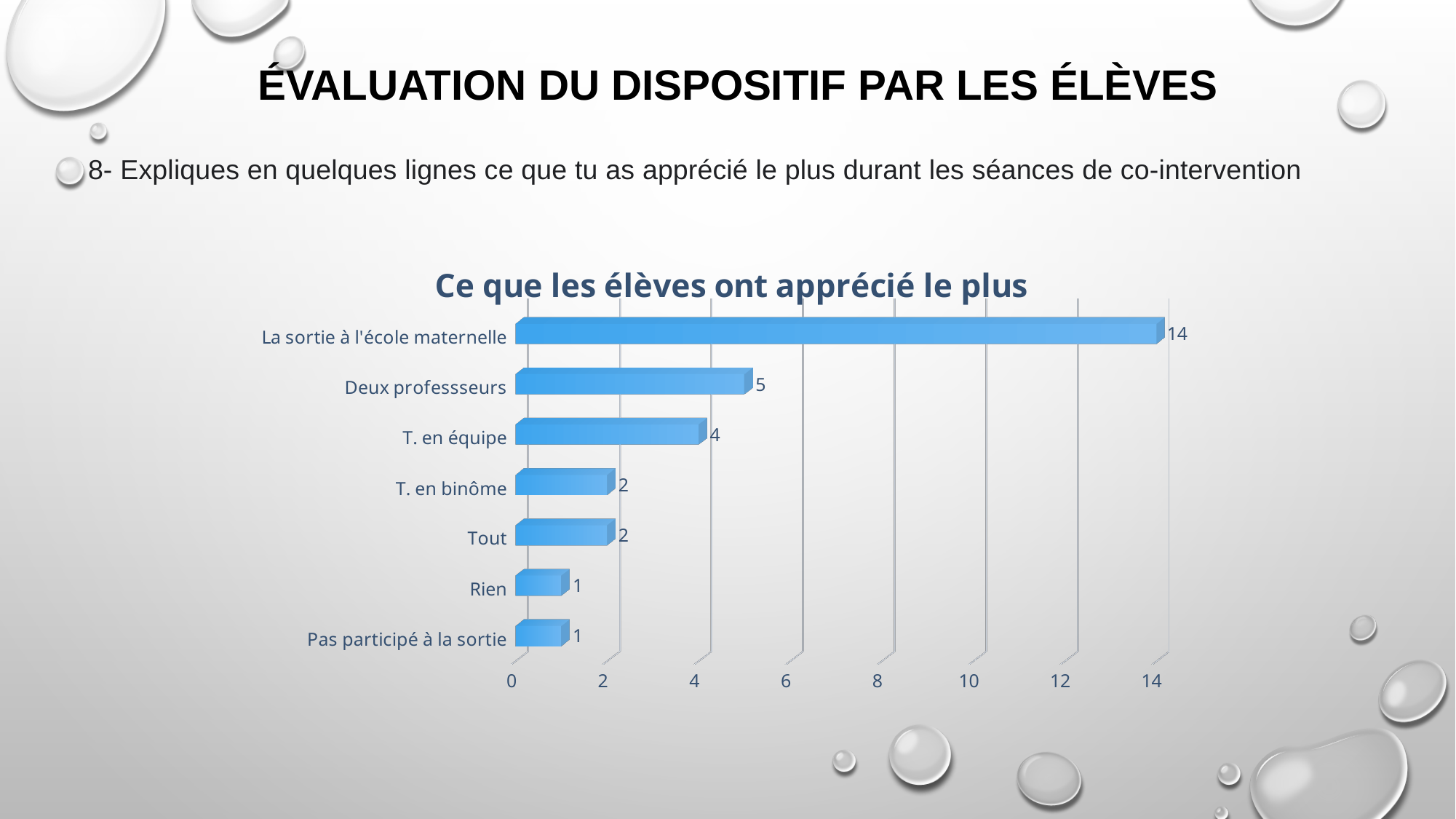
Which category has the highest value? La sortie à l'école maternelle How many categories are shown in the chart? 7 What kind of chart is shown on the slide? Bar chart What is the value for "T. en équipe"? 4 Which is larger, the value for "T. en équipe" or the value for "T. en binôme"? T. en équipe What is the difference between the values for "La sortie à l'école maternelle" and "Deux professseurs"? 9 What is the value for "Rien"? 1 What is the value for "La sortie à l'école maternelle"? 14 What is the title of the chart? Ce que les élèves ont apprécié le plus What is the difference between the values for "T. en binôme" and "Rien"? 1 Is the value for "La sortie à l'école maternelle" greater or less than 12? greater What is the value for "Deux professseurs"? 5